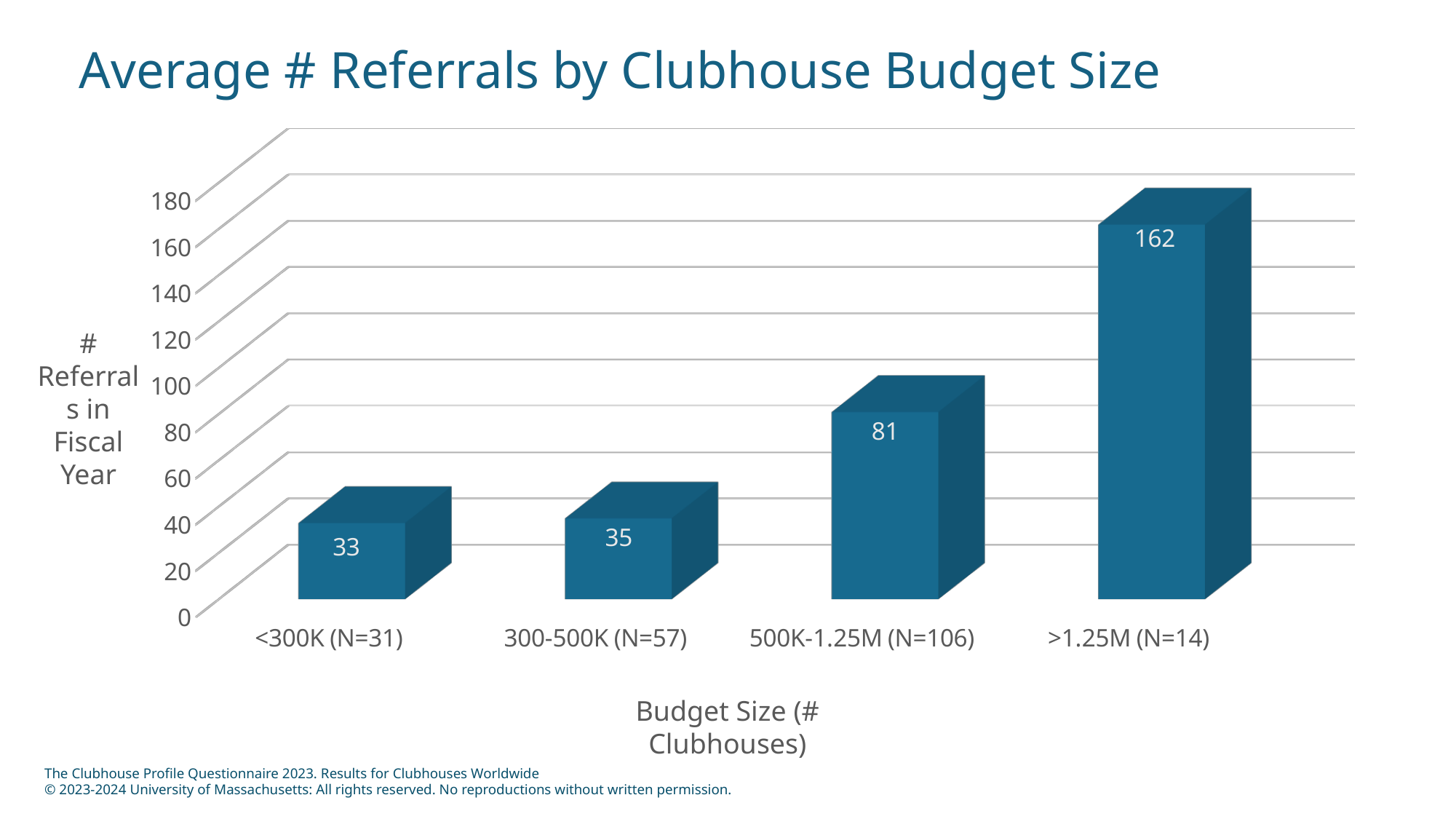
Which budget size category has the highest average number of referrals? >1.25M (N=14) What is the average number of referrals for clubhouses with a budget of >1.25M (N=14)? 162 Which has a higher average number of referrals: 500K-1.25M (N=106) or 300-500K (N=57)? 500K-1.25M (N=106) Do the average referral values rise or fall as budget size increases along the x axis? Rise What is the average number of referrals for clubhouses with a budget of <300K (N=31)? 33 What is the difference in average referrals between the >1.25M (N=14) and 500K-1.25M (N=106) categories? 81 What type of chart is shown on the slide? Bar chart What is the average number of referrals for clubhouses with a budget of 300-500K (N=57)? 35 How many budget size categories are shown in the chart? 4 What is the average number of referrals for clubhouses with a budget of 500K-1.25M (N=106)? 81 Which budget size category has the lowest average number of referrals? <300K (N=31) What is the difference in average referrals between the 300-500K (N=57) and <300K (N=31) categories? 2